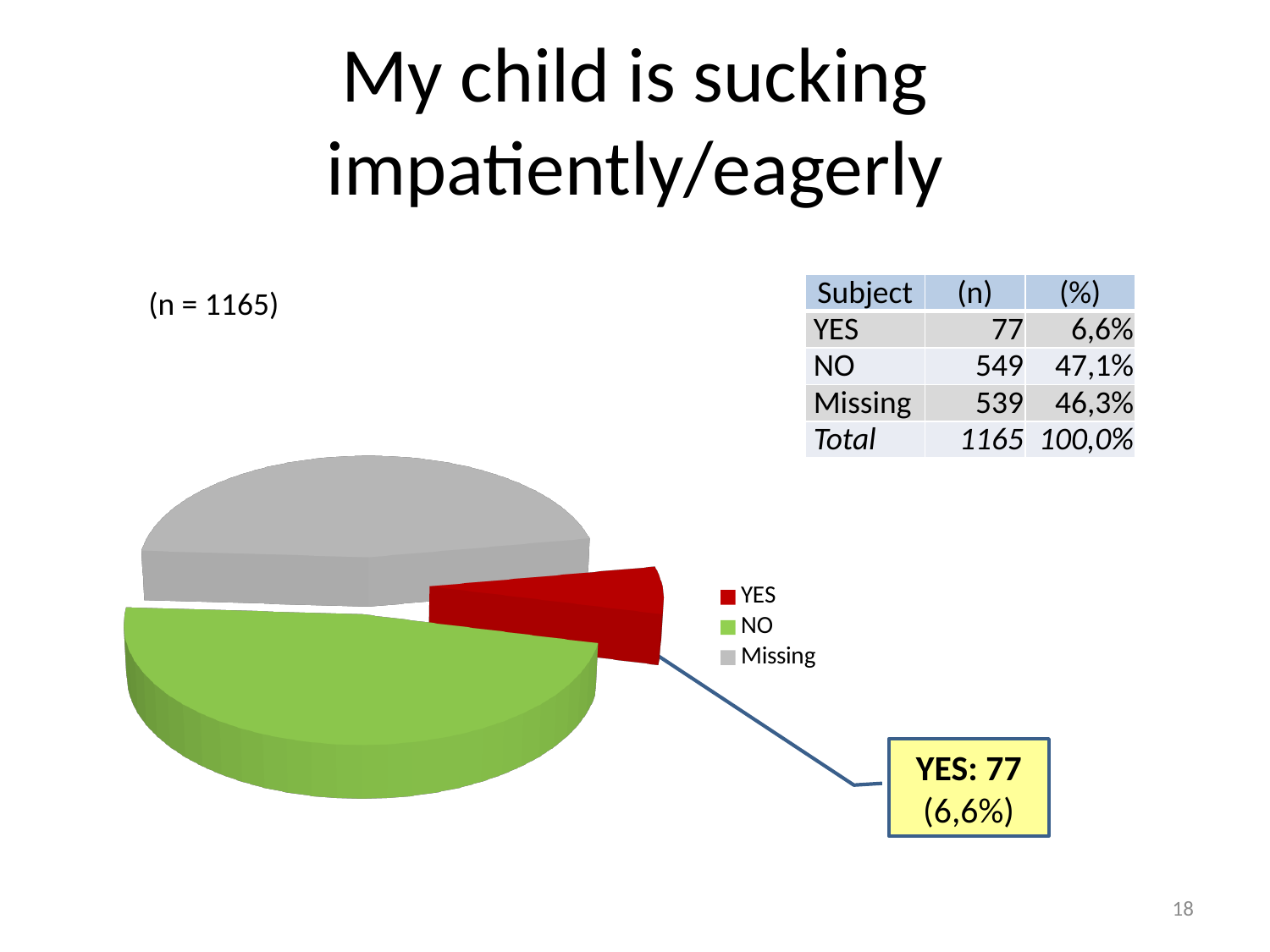
What kind of chart is shown on the slide? pie chart What colour is the YES slice in the pie chart? red How many slices does the pie chart have? 3 What is the difference in count between the NO and Missing categories? 10 Which category has the smallest slice in the pie chart? YES How many entries does the legend of the pie chart list? 3 What is the count for the YES slice of the pie chart? 77 What percentage share does the Missing slice represent? 46,3% What is the count for the Missing category? 539 Which category has the largest slice in the pie chart? NO What is the count for the NO category? 549 What percentage share does the YES slice represent? 6,6%